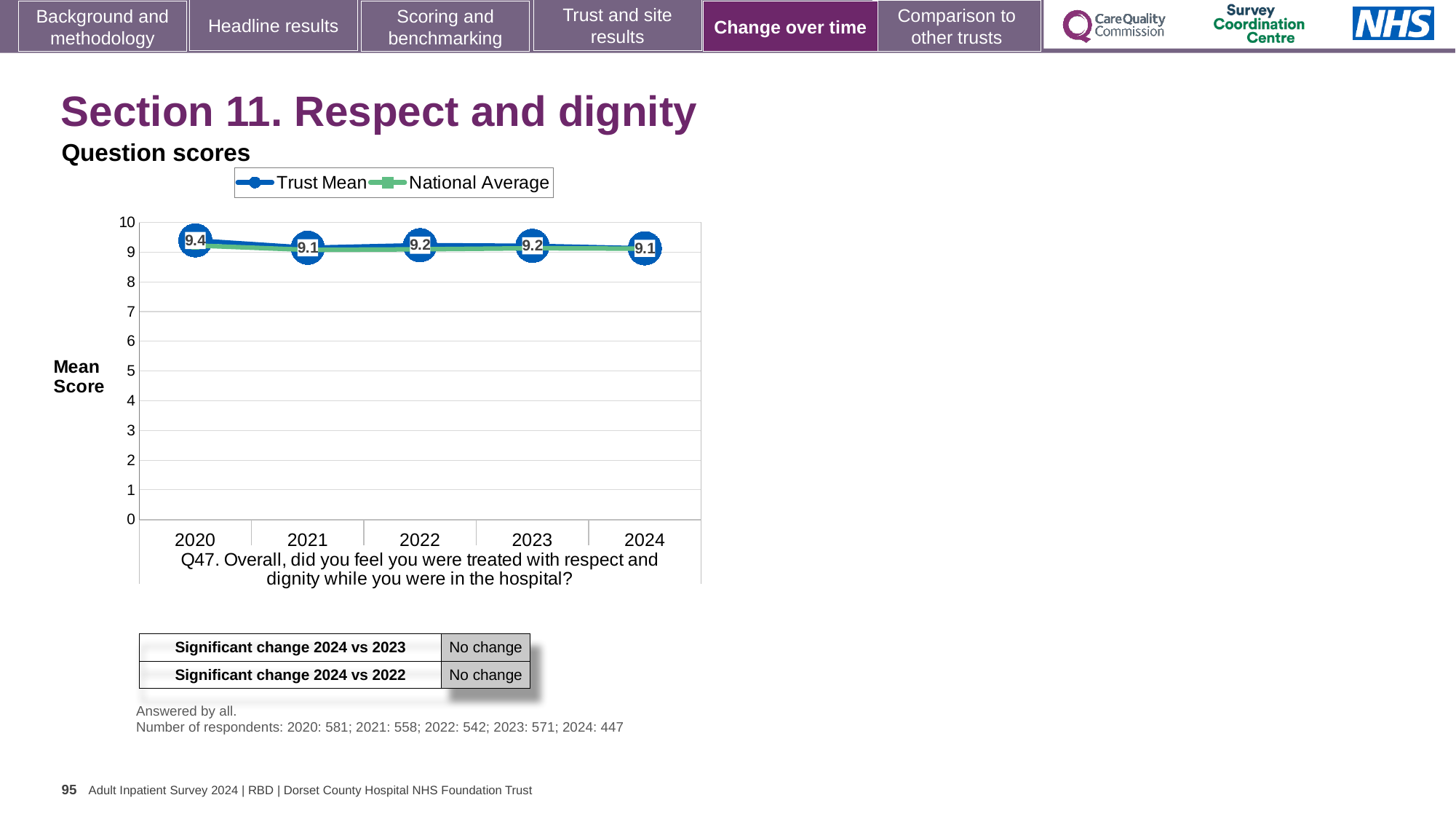
What are the two series named in the legend? Trust Mean and National Average What kind of chart is shown on the slide? Line chart What is the Trust Mean score for 2022? 9.2 What is the difference between the Trust Mean scores for 2020 and 2021? 0.3 How many series does the legend list? 2 Does the Trust Mean score rise or fall from 2020 to 2021? Fall How many years are plotted on the x axis? 5 In which year is the Trust Mean score highest? 2020 Which is larger, the Trust Mean score for 2020 or for 2024? 2020 Is the National Average value for 2024 greater or less than 8? greater What is the Trust Mean score for 2024? 9.1 What is the Trust Mean score for 2020? 9.4